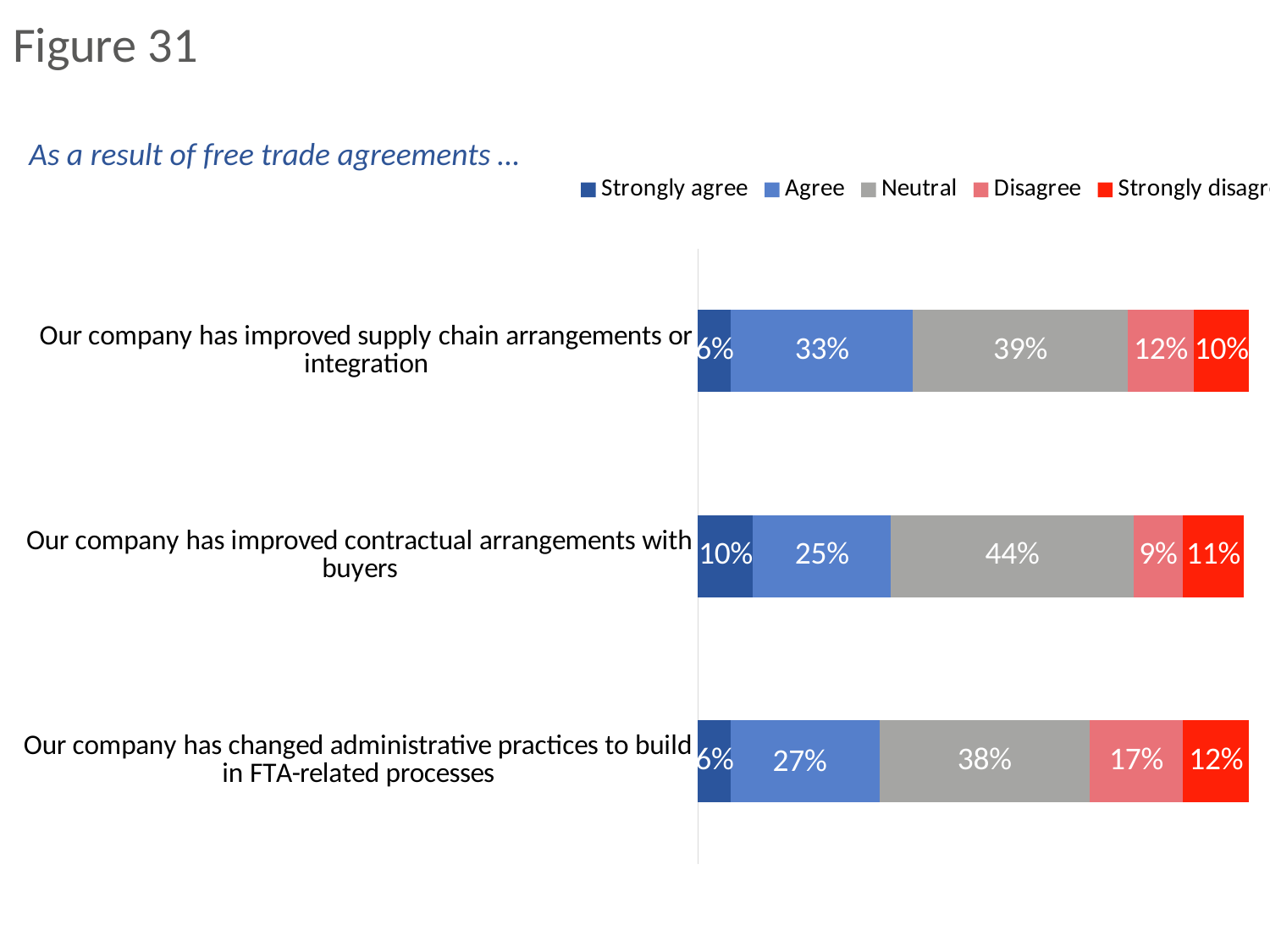
What is the Strongly disagree value for 'Our company has improved supply chain arrangements or integration'? 10% What is the difference between the Disagree values for the administrative practices statement and the contractual arrangements statement? 8 percentage points What is the Neutral value for 'Our company has improved contractual arrangements with buyers'? 44% How many series does the legend list? 5 Which has a larger Agree value: the supply chain statement or the administrative practices statement? The supply chain statement How many statements (categories) are plotted in the chart? 3 What is the first entry in the chart legend? Strongly agree Which statement has the highest Neutral share? Our company has improved contractual arrangements with buyers Which statement has the lowest Disagree share? Our company has improved contractual arrangements with buyers What kind of chart is shown on the slide? Stacked bar chart What is the Disagree value for 'Our company has changed administrative practices to build in FTA-related processes'? 17% What is the Agree value for 'Our company has improved supply chain arrangements or integration'? 33%